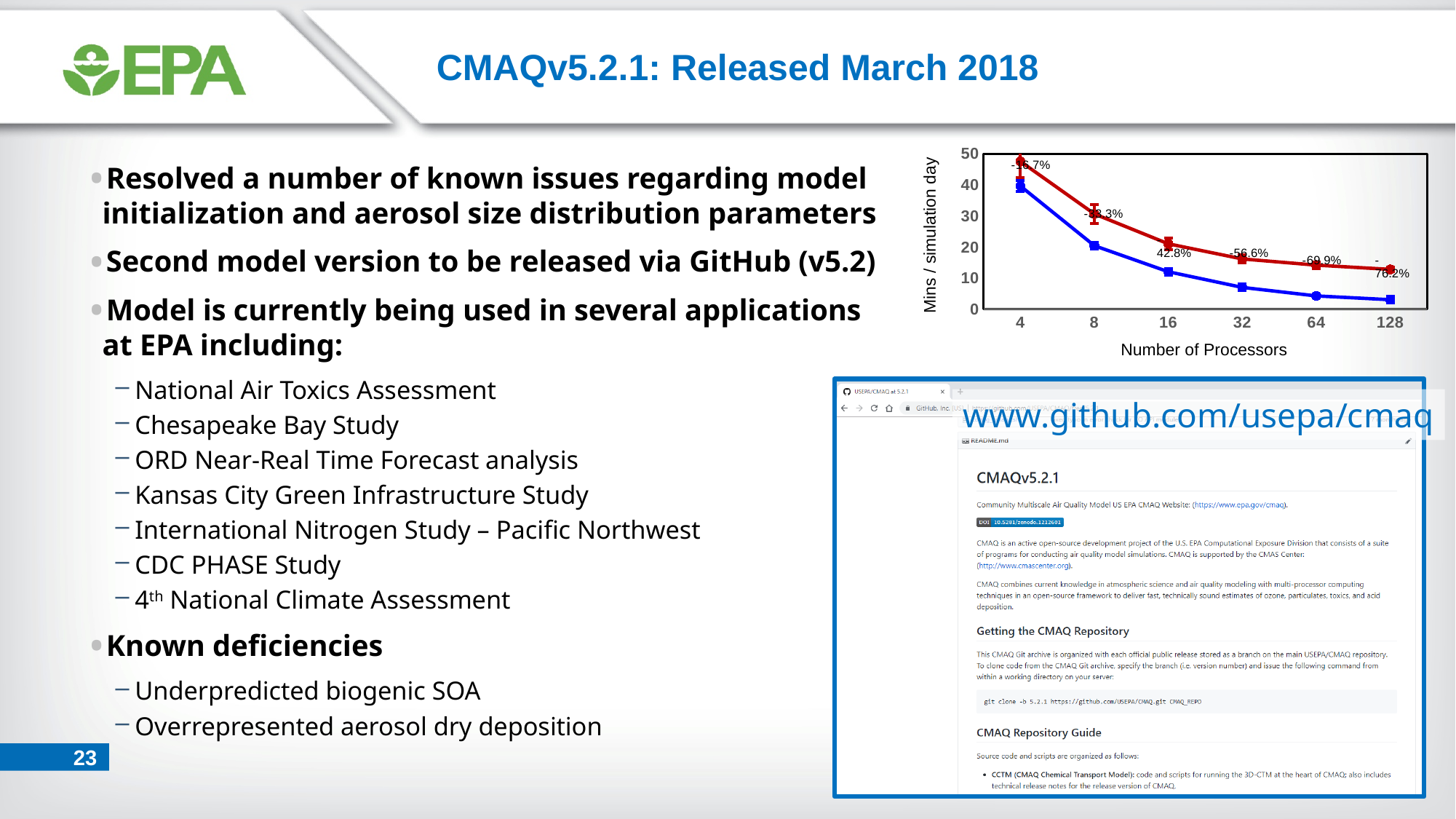
Is the value of the blue line at 128 processors greater or less than 10? less What percentage label is shown at 64 processors on the chart? -69.9% What percentage label is shown at 128 processors on the chart? -76.2% What is the x-axis title of the chart? Number of Processors What percentage label is shown at 32 processors on the chart? -56.6% What is the y-axis title of the chart? Mins / simulation day What kind of chart is shown in the top right of the slide? line chart Is the value of the red line at 4 processors greater or less than 40? greater At 8 processors, which line has the higher value, the red line or the blue line? red line What percentage label is shown at 4 processors on the chart? -16.7% Do the values of the red line rise or fall as the number of processors increases? fall How many processor counts are shown on the x axis of the chart? 6